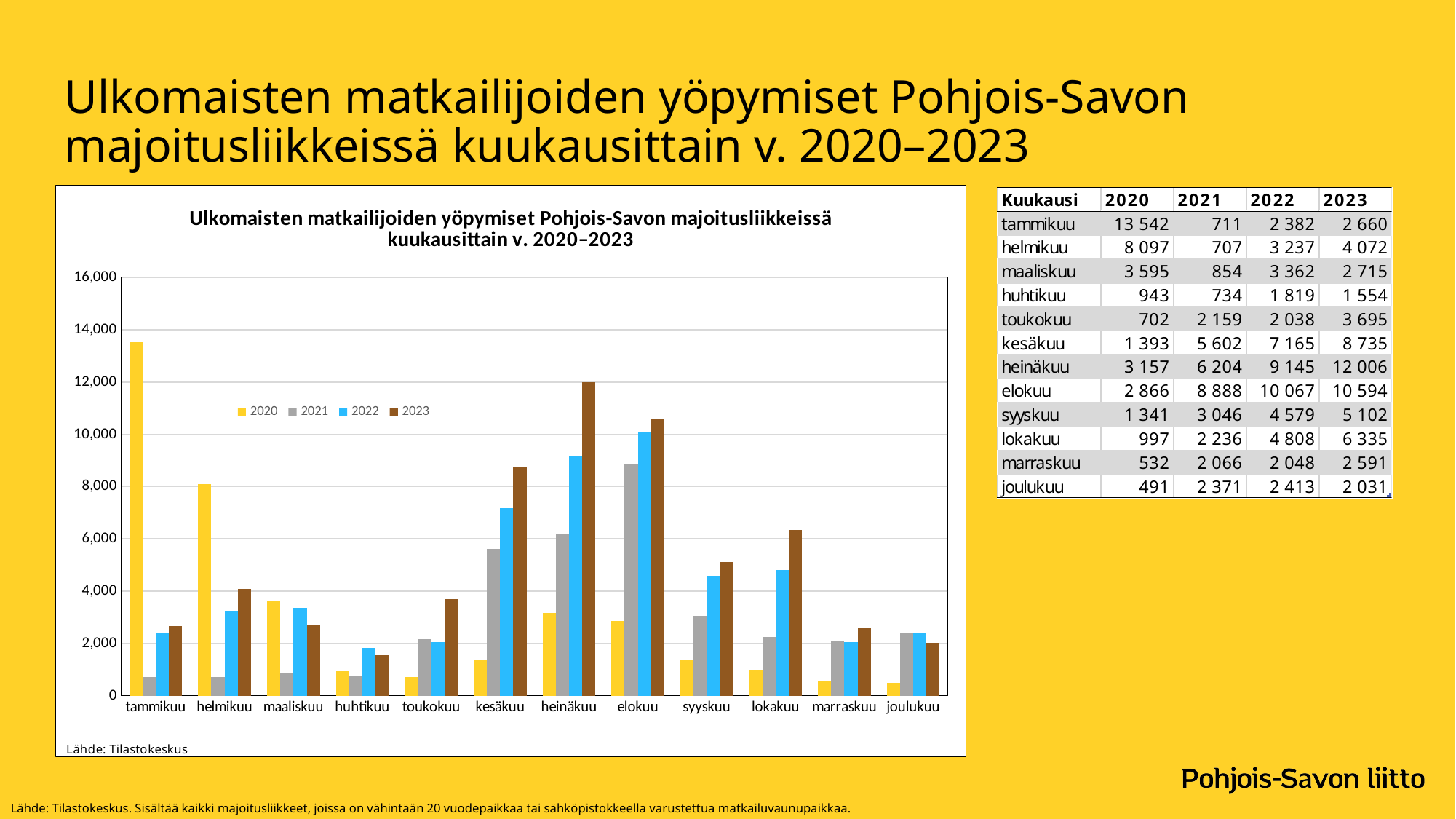
For elokuu, which year has the larger value, 2022 or 2023? 2023 Which colour represents the 2020 series in the chart legend? Yellow How many series does the chart legend list? 4 What kind of chart is shown on the slide? Bar chart Which month has the highest value in the 2023 series? heinäkuu Which month has the lowest value in the 2020 series? joulukuu What is the value for tammikuu in 2020? 13 542 What is the value for lokakuu in 2023? 6 335 Is the value for tammikuu in 2020 greater or less than 12,000? greater What is the difference between the 2023 and 2022 values for heinäkuu? 2 861 Do the 2023 values rise or fall from toukokuu to heinäkuu? rise How many months (categories) are shown on the x axis of the chart? 12